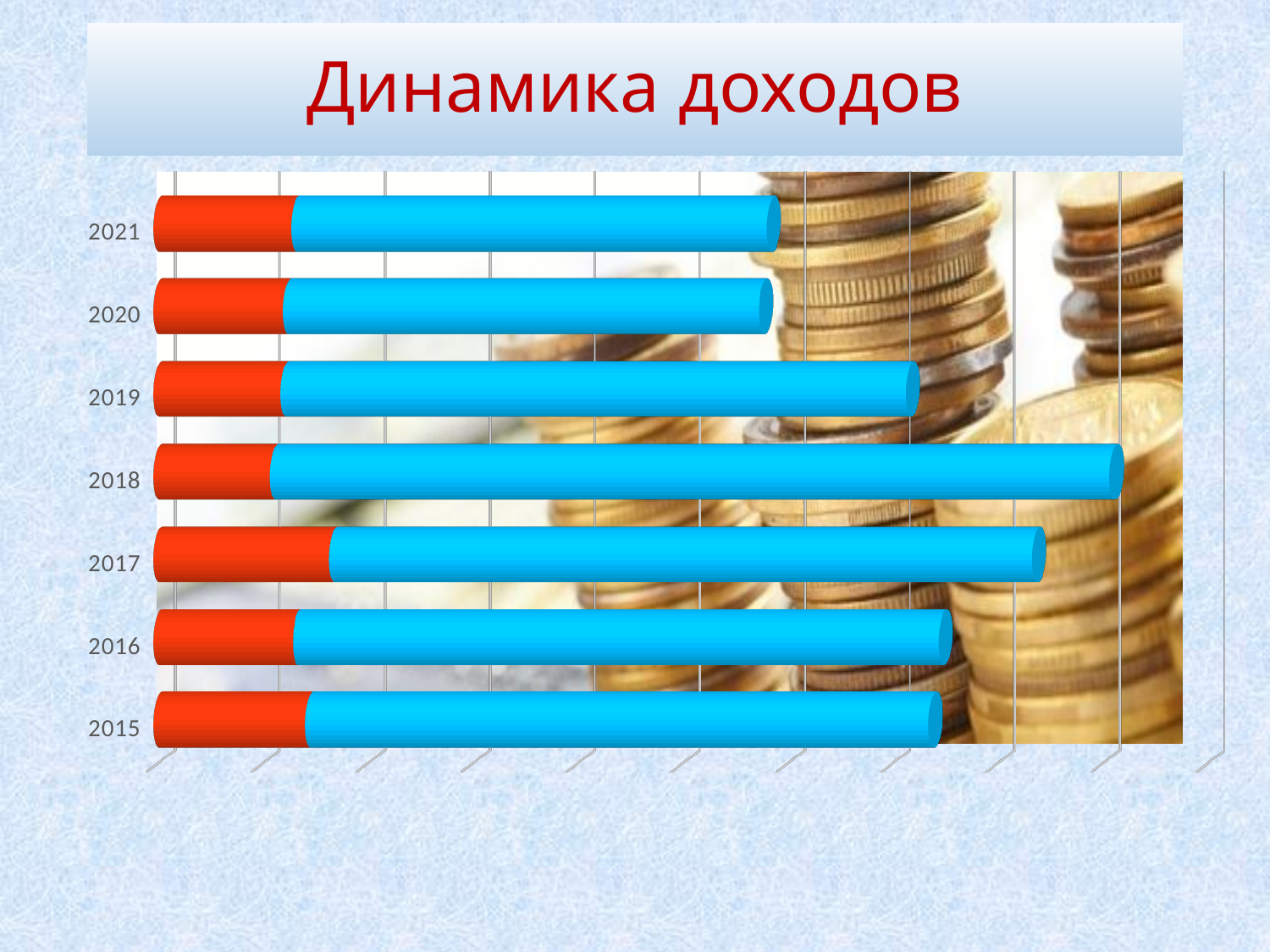
Which year has the longest total bar? 2018 Which year has the longer total bar, 2016 or 2020? 2016 Which year is listed at the top of the chart? 2021 Which year has the longer total bar, 2017 or 2019? 2017 How many years are shown on the chart? 7 Which year has the longest red segment? 2017 Do the total bars rise or fall from 2018 to 2020? fall Is the total bar for 2018 longer or shorter than the total bar for 2015? longer Do the total bars rise or fall from 2015 to 2018? rise What two colours are used for the bar segments? red and blue What is the title of the chart? Динамика доходов What kind of chart is shown on the slide? bar chart